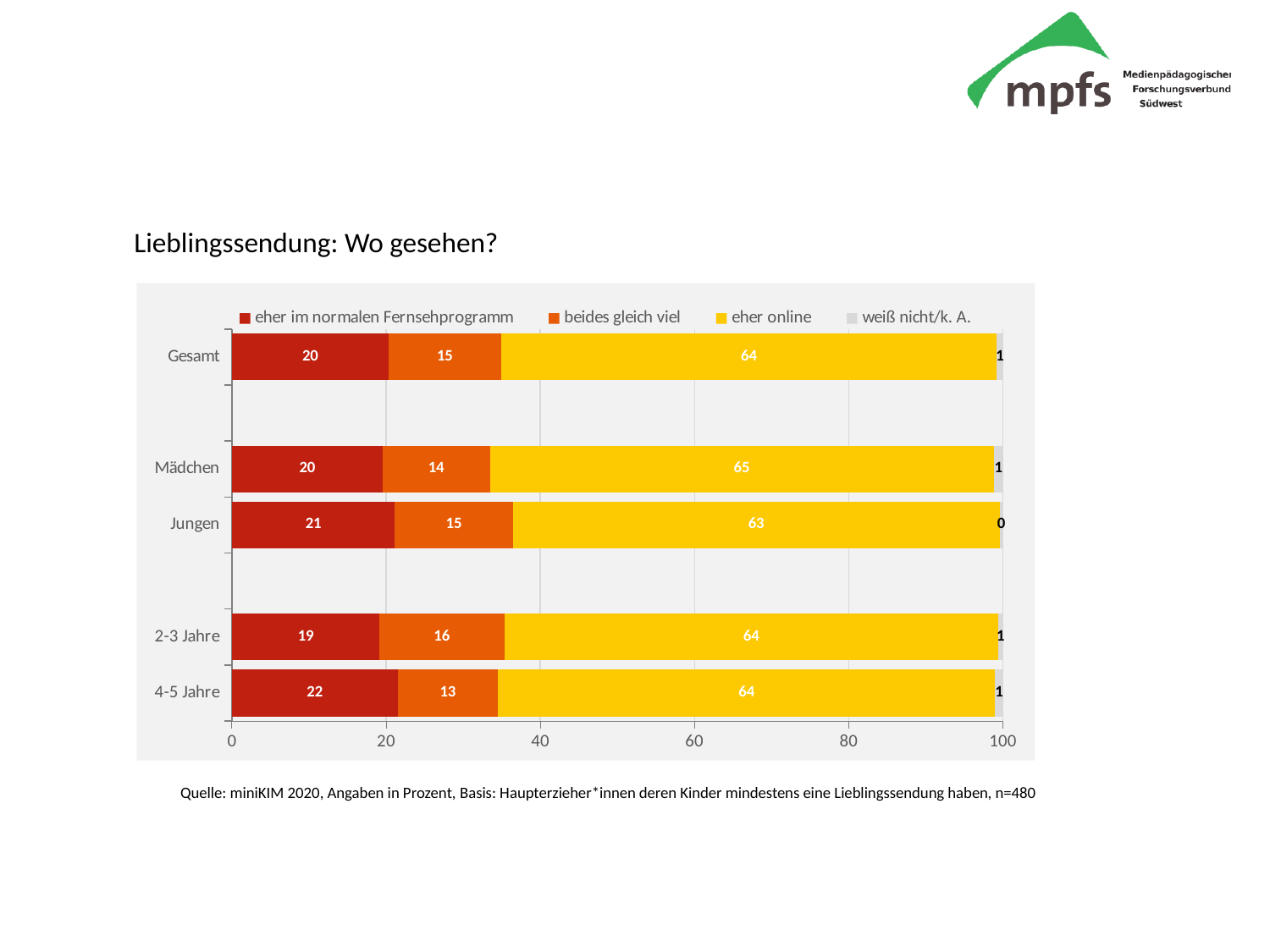
How many series does the legend list? 4 Which category has the lowest value for "eher im normalen Fernsehprogramm"? 2-3 Jahre What is the value for "weiß nicht/k. A." for Jungen? 0 What is the total of the Jungen bar? 99 What is the difference between the "eher im normalen Fernsehprogramm" values for 4-5 Jahre and 2-3 Jahre? 3 What kind of chart is shown? Stacked bar chart Which category has the highest value for "eher online"? Mädchen What is the value for "eher im normalen Fernsehprogramm" for 4-5 Jahre? 22 What is the value for "eher online" in the Gesamt bar? 64 Is the "beides gleich viel" value larger for 2-3 Jahre or for 4-5 Jahre? 2-3 Jahre What is the value for "beides gleich viel" for 2-3 Jahre? 16 How many categories are shown on the y axis? 5